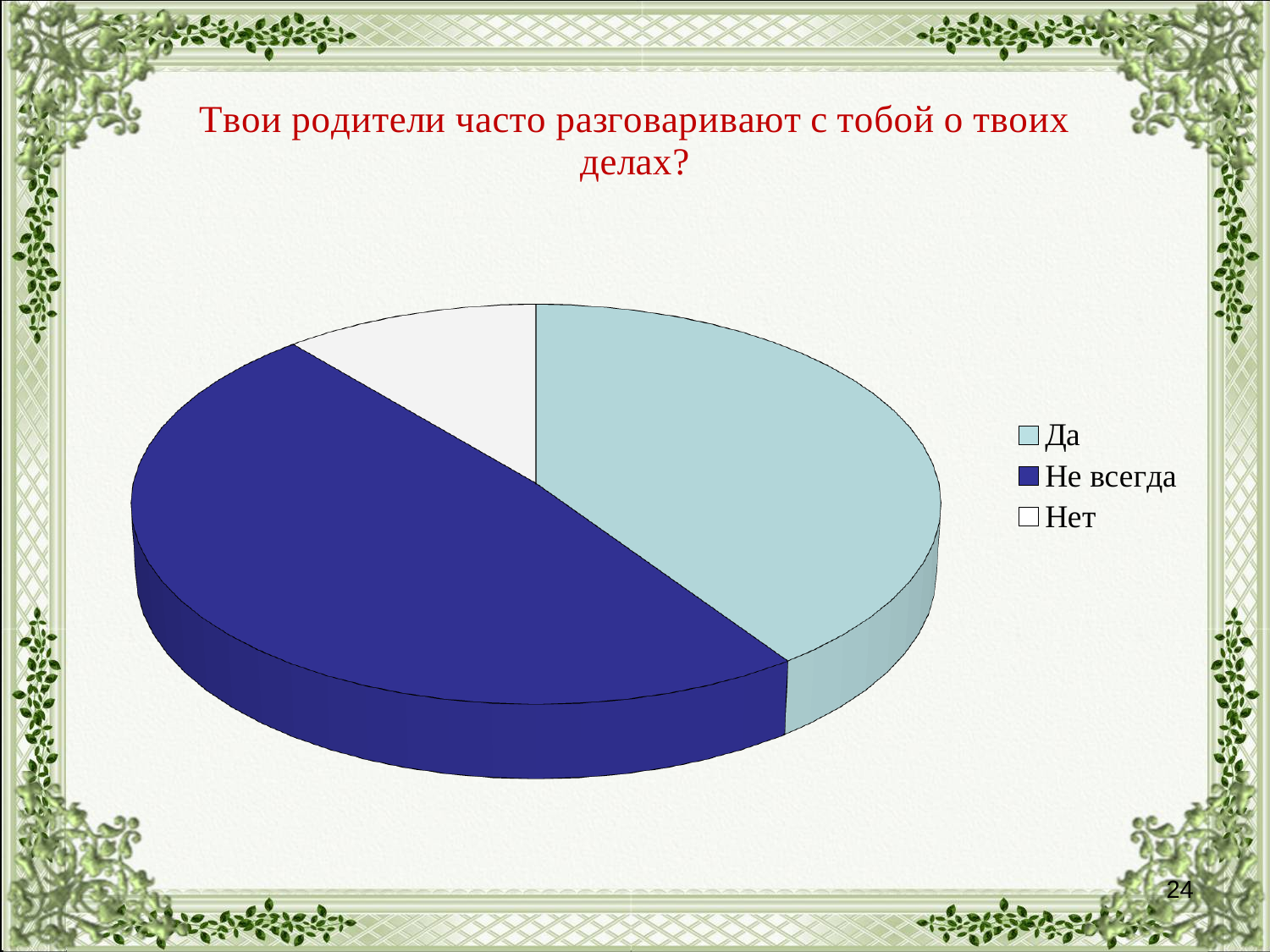
What kind of chart is shown on the slide? pie chart Which slice is larger, Не всегда or Нет? Не всегда What is the title of the chart? Твои родители часто разговаривают с тобой о твоих делах? Which answer has the largest slice of the pie? Не всегда Which legend entry is shown in dark blue? Не всегда Which answer has the smallest slice of the pie? Нет How many entries does the legend list? 3 Which slice is larger, Да or Нет? Да How many slices does the pie chart have? 3